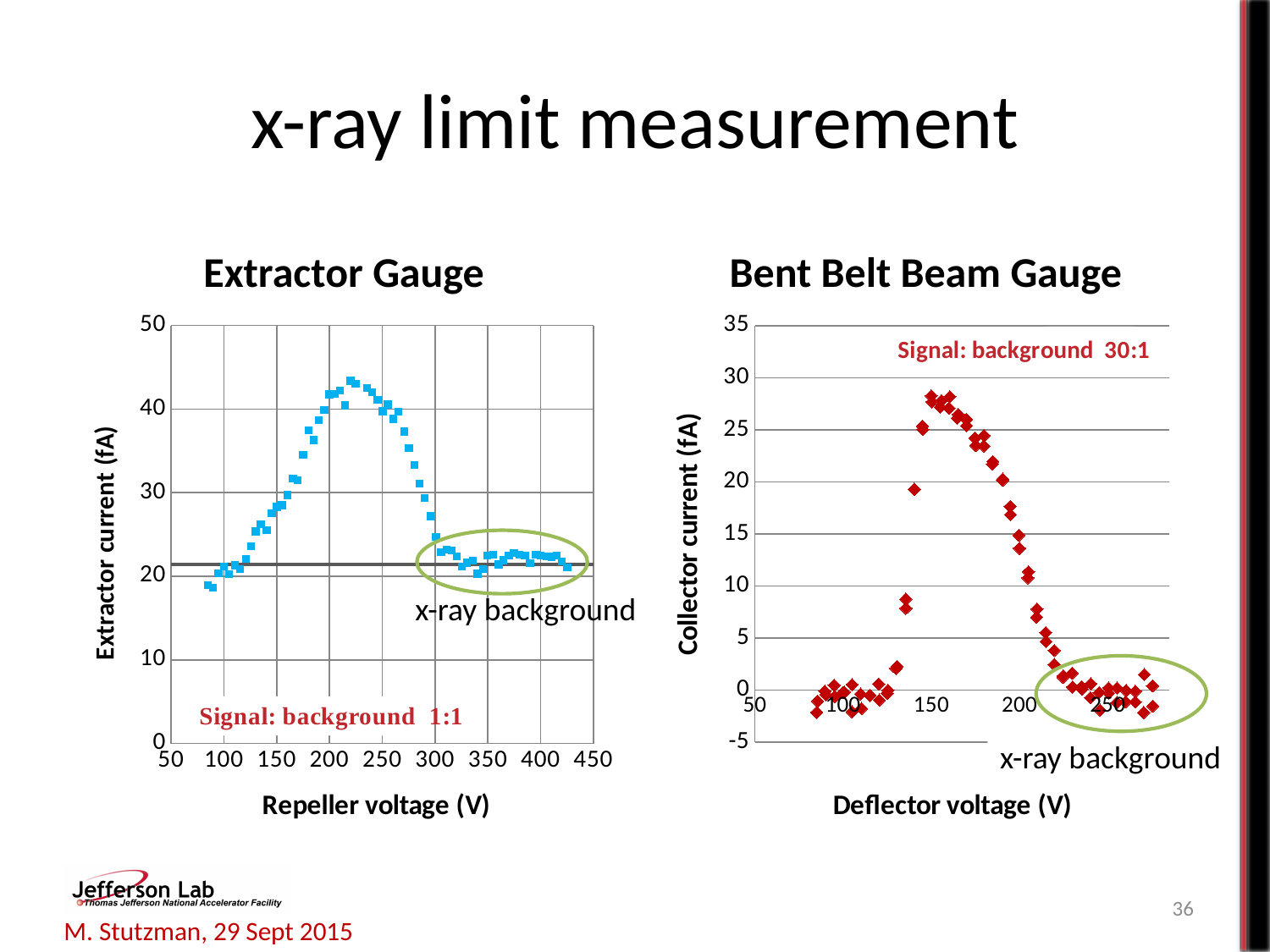
What kind of chart is the Extractor Gauge chart? scatter chart In the Bent Belt Beam Gauge chart, is the collector current at a deflector voltage of 250 V greater or less than 5 fA? less What is the x-axis title of the Extractor Gauge chart? Repeller voltage (V) In the Extractor Gauge chart, is the extractor current at a repeller voltage of 220 V greater or less than 40 fA? greater In the Extractor Gauge chart, do the values rise or fall as the repeller voltage goes from 250 V to 300 V? fall In the Bent Belt Beam Gauge chart, is the collector current at a deflector voltage of 150 V greater or less than 25 fA? greater What kind of chart is the Bent Belt Beam Gauge chart? scatter chart Which chart reaches a higher peak current, the Extractor Gauge chart or the Bent Belt Beam Gauge chart? Extractor Gauge In the Bent Belt Beam Gauge chart, do the values rise or fall as the deflector voltage goes from 100 V to 150 V? rise What signal-to-background ratio is stated on the Bent Belt Beam Gauge chart? 30:1